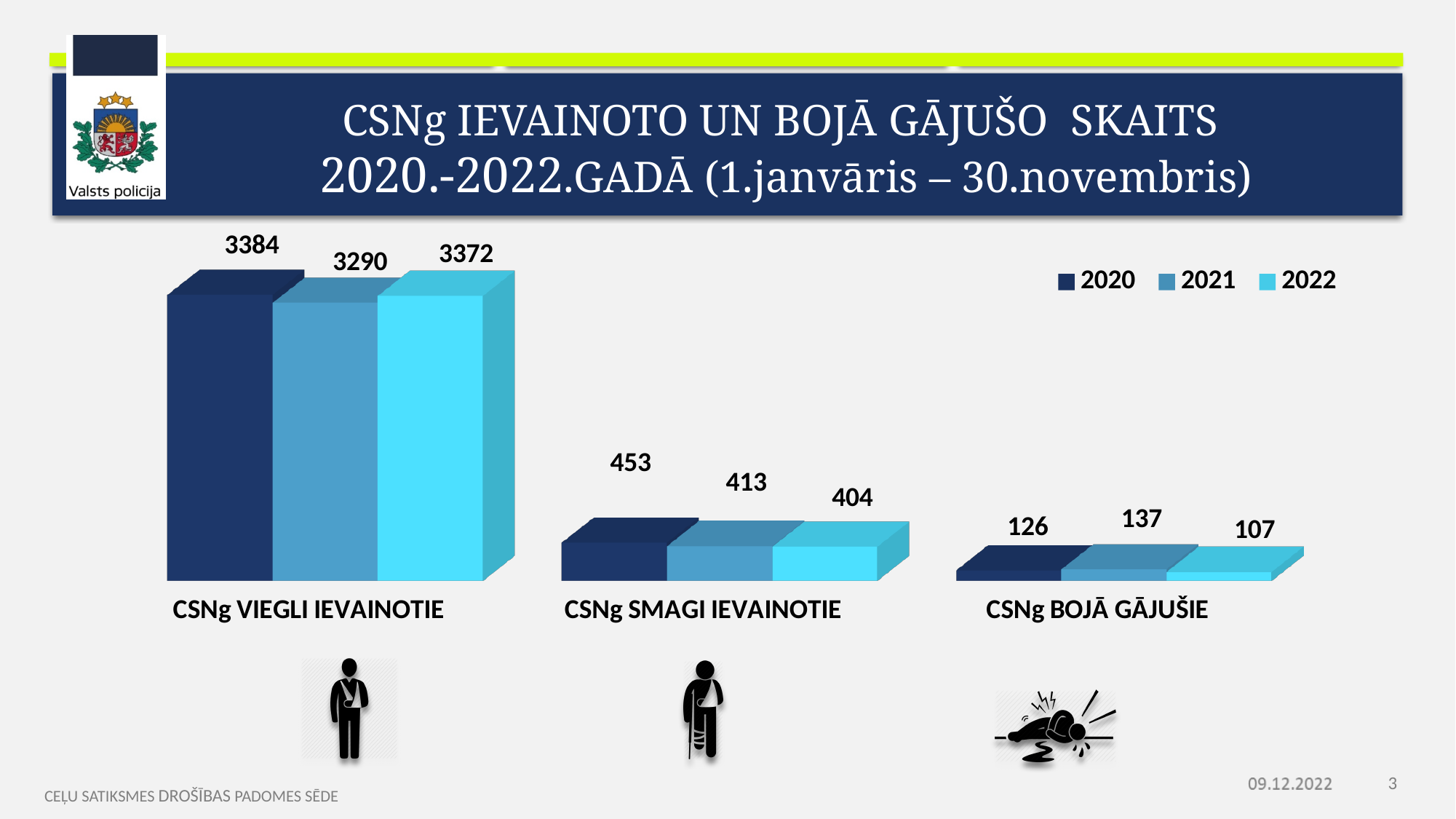
Which is larger in the CSNg BOJĀ GĀJUŠIE category: the 2020 value or the 2022 value? 2020 What is the value for 2022 in the CSNg BOJĀ GĀJUŠIE category? 107 What kind of chart is shown on the slide? Bar chart Which series is shown in the darkest blue colour? 2020 How many categories are shown on the x axis? 3 How many series does the legend list? 3 Do the values for 2020 rise or fall across the categories from left to right? Fall Which year has the lowest value in the CSNg VIEGLI IEVAINOTIE category? 2021 Which year has the highest value in the CSNg BOJĀ GĀJUŠIE category? 2021 What is the value for 2020 in the CSNg VIEGLI IEVAINOTIE category? 3384 What is the value for 2021 in the CSNg SMAGI IEVAINOTIE category? 413 What is the difference between the 2020 and 2022 values in the CSNg SMAGI IEVAINOTIE category? 49